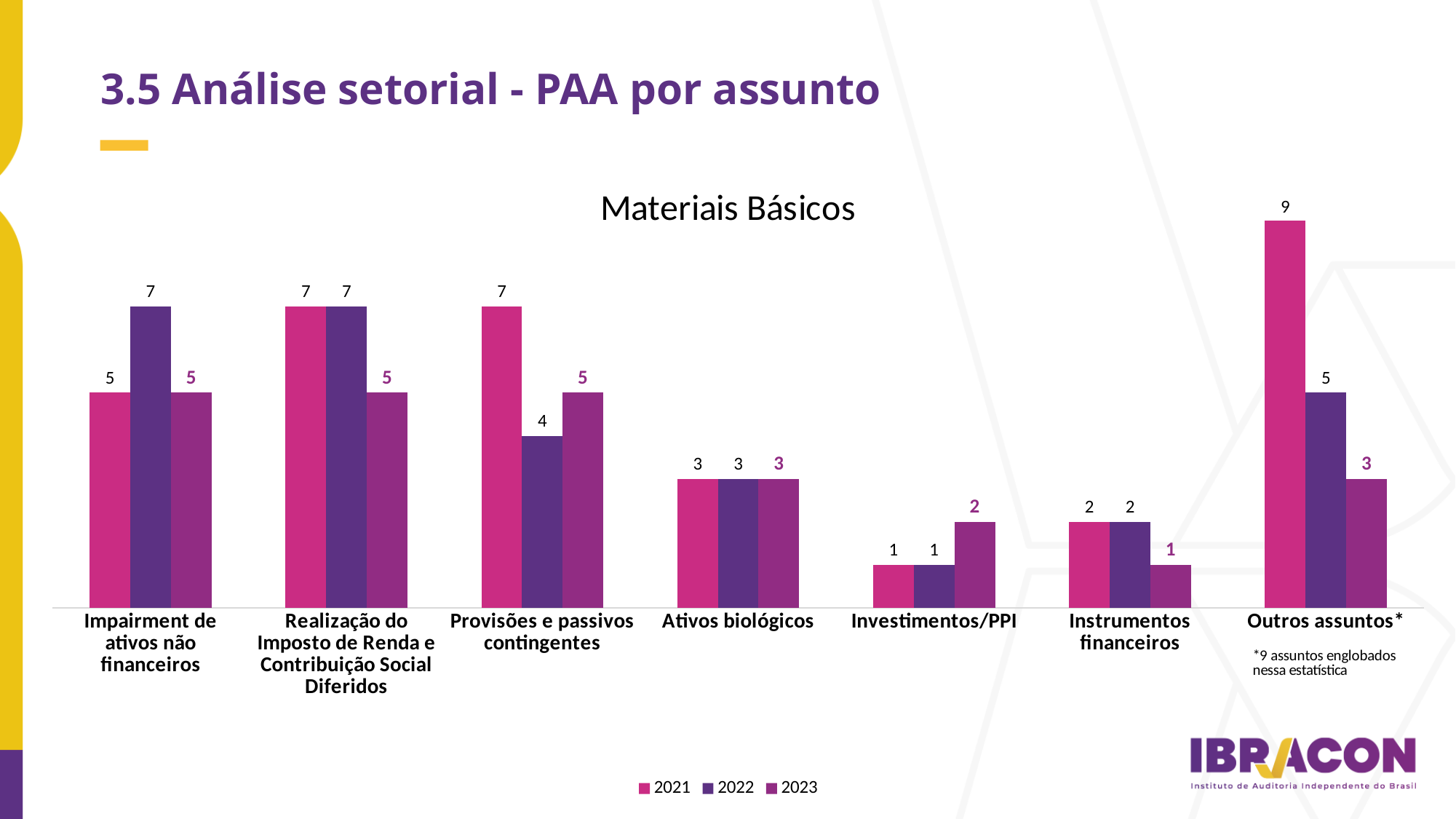
What kind of chart is shown on the slide? Bar chart What is the value for 2021 in the 'Outros assuntos*' category? 9 What is the value for 2023 in the 'Provisões e passivos contingentes' category? 5 What is the value for 2022 in the 'Impairment de ativos não financeiros' category? 7 What is the total of the three series values for 'Ativos biológicos'? 9 What is the title of the chart? Materiais Básicos Which category has the lowest value for the 2023 series? Instrumentos financeiros Which category has the highest value for the 2021 series? Outros assuntos* How many series does the legend list? 3 Which is larger for 'Provisões e passivos contingentes': the 2022 value or the 2023 value? 2023 What is the difference between the 2021 and 2023 values for 'Outros assuntos*'? 6 How many categories are shown on the x axis? 7